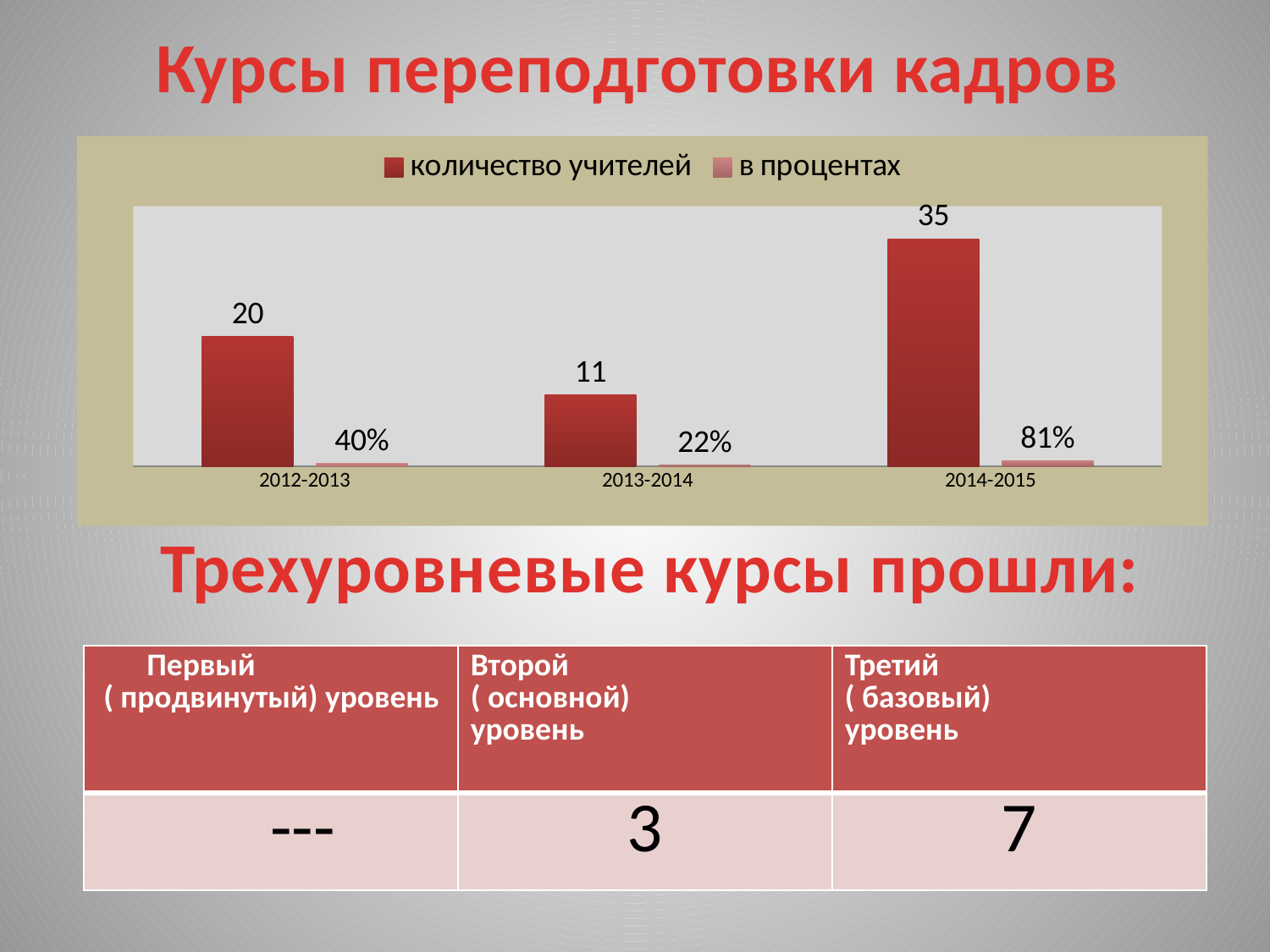
How many series does the legend list? 2 Which year has the lowest value for "в процентах"? 2013-2014 What are the two series named in the legend? количество учителей, в процентах What is the value of "количество учителей" for 2014-2015? 35 Which year has the highest value for "количество учителей"? 2014-2015 What is the value of "в процентах" for 2012-2013? 40% How many year categories are shown on the x axis? 3 What is the difference in "количество учителей" between 2014-2015 and 2012-2013? 15 Which is larger, "количество учителей" for 2012-2013 or for 2013-2014? 2012-2013 What kind of chart is shown on the slide? bar chart What is the value of "в процентах" for 2014-2015? 81% What is the value of "количество учителей" for 2013-2014? 11